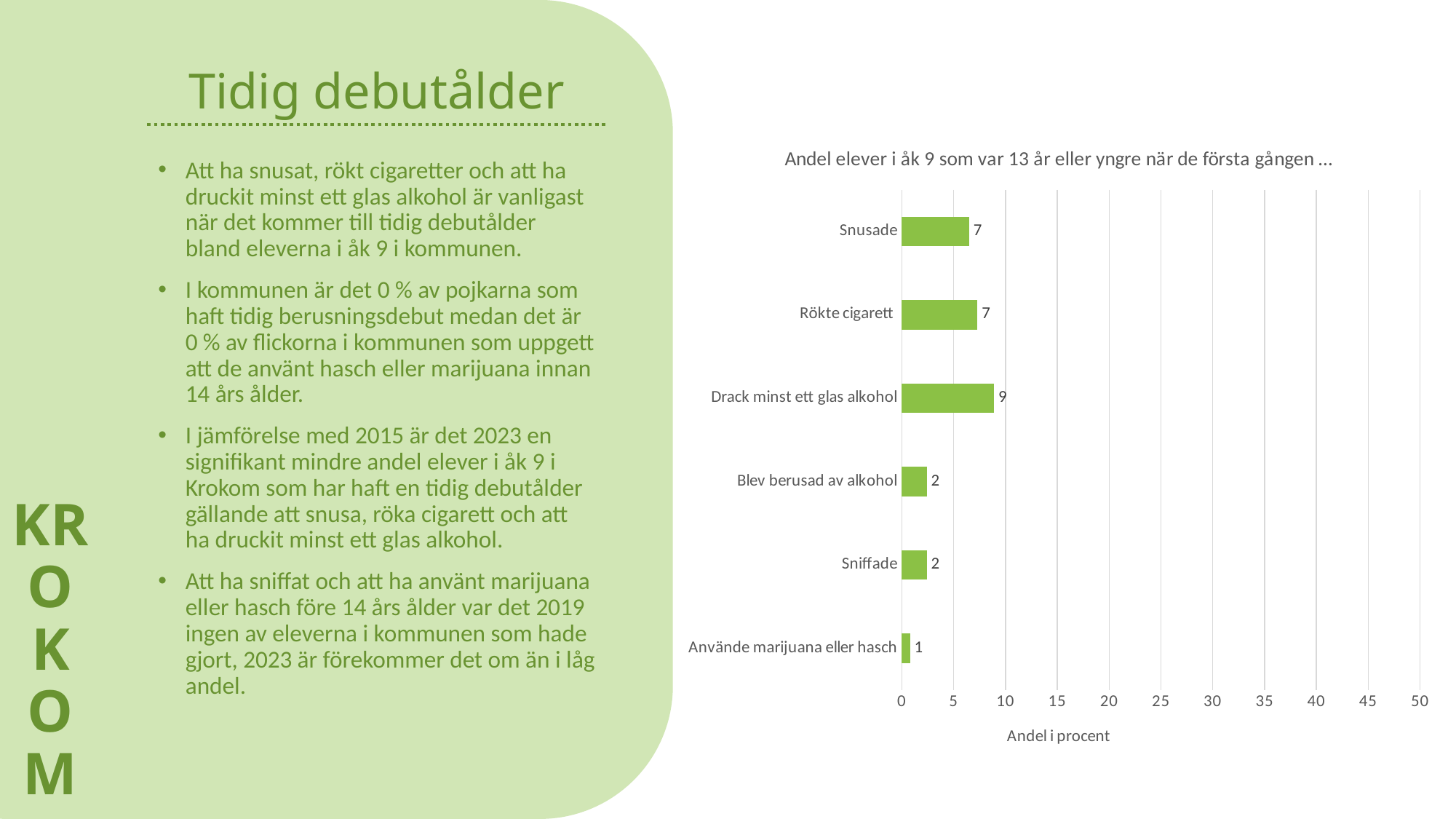
What is the value for Använde marijuana eller hasch? 1 Which category has the lowest value? Använde marijuana eller hasch Is the value for Drack minst ett glas alkohol greater or less than 10? less What is the label of the horizontal axis of the chart? Andel i procent What is the difference between the values for Drack minst ett glas alkohol and Sniffade? 7 What is the value for Blev berusad av alkohol? 2 Which is larger, the value for Rökte cigarett or the value for Blev berusad av alkohol? Rökte cigarett Which category has the highest value? Drack minst ett glas alkohol What kind of chart is shown on the slide? bar chart How many categories are shown in the chart? 6 What is the value for Drack minst ett glas alkohol? 9 What is the value for Snusade? 7